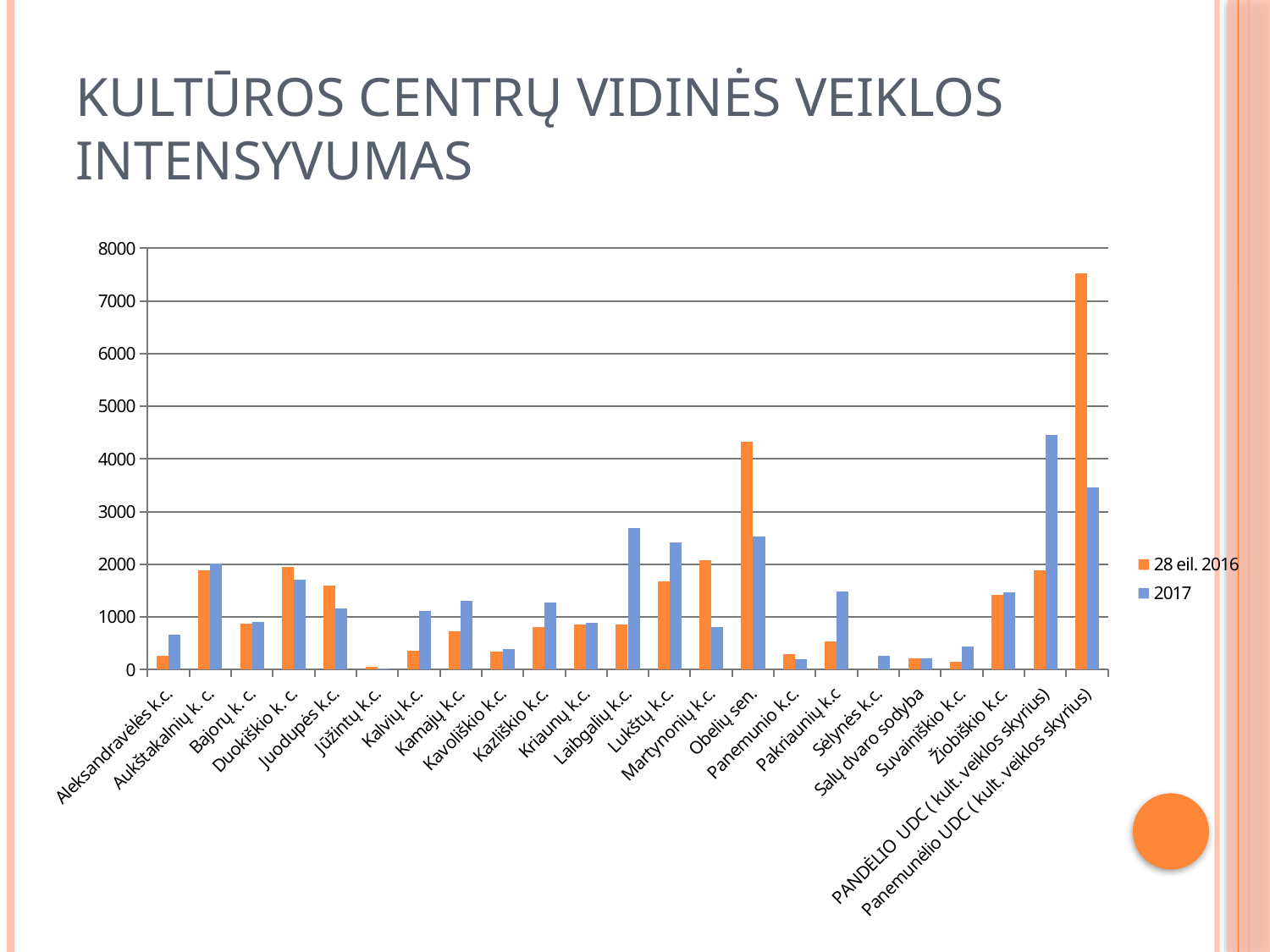
How many categories are shown on the x axis? 23 For Martynonių k.c., which series has the larger value, 28 eil. 2016 or 2017? 28 eil. 2016 Is the 2017 value for Laibgalių k.c. greater or less than 2000? greater Which category has the highest value in the 28 eil. 2016 series? Panemunėlio UDC ( kult. veiklos skyrius) Which category has the highest value in the 2017 series? PANDĖLIO UDC ( kult. veiklos skyrius) What kind of chart is shown on the slide? bar chart Is the 2017 value for Panemunėlio UDC ( kult. veiklos skyrius) greater or less than 4000? less How many series does the legend list? 2 Is the 2017 value for Aleksandravėlės k.c. greater or less than 1000? less What colour are the bars for the 2017 series? blue For Laibgalių k.c., which series has the larger value, 28 eil. 2016 or 2017? 2017